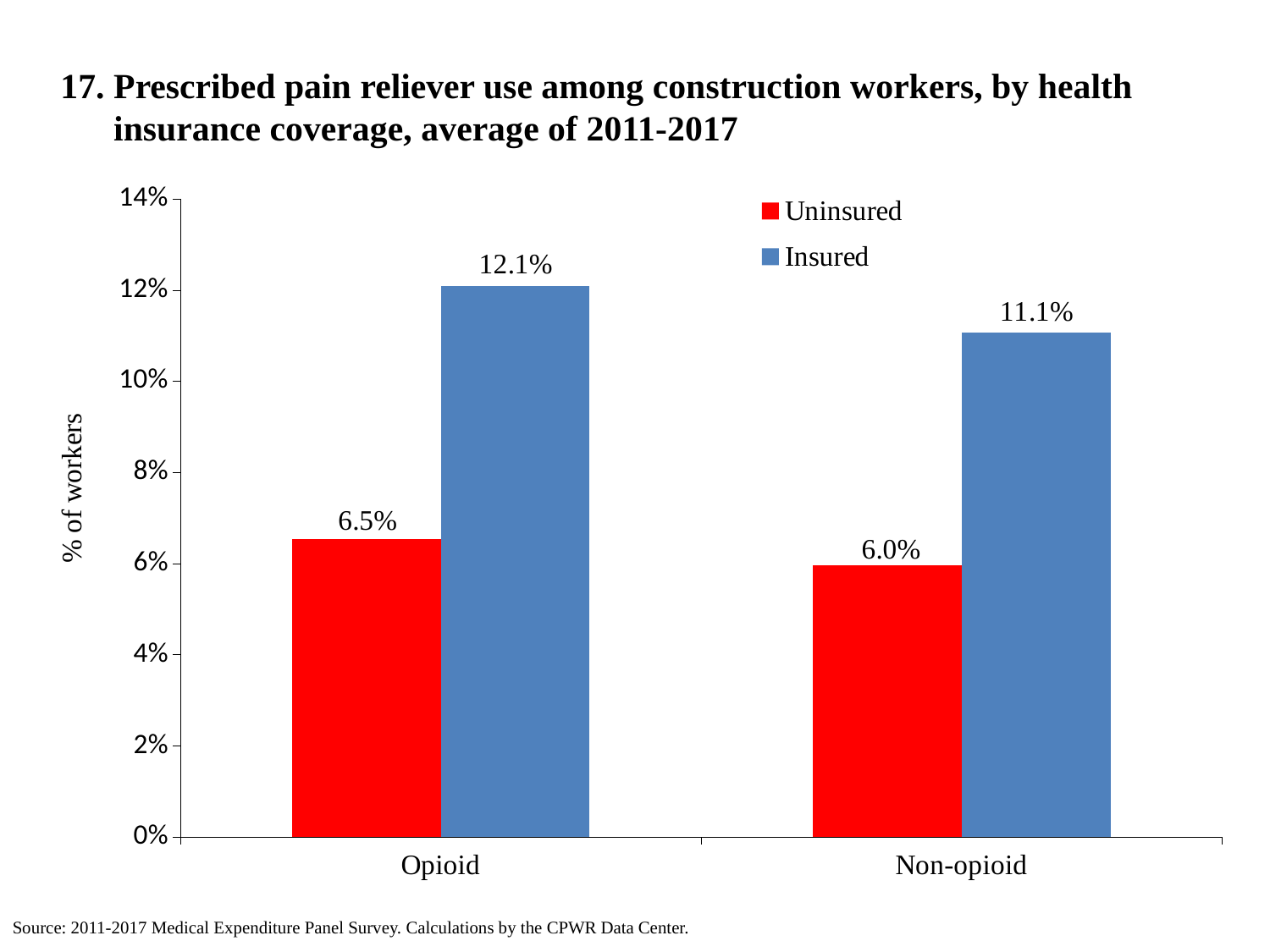
Which bar has the highest value on the chart? Insured, Opioid Which bar has the lowest value on the chart? Uninsured, Non-opioid Which is larger: the Insured value for Opioid or the Insured value for Non-opioid? Insured value for Opioid What is the value for Uninsured workers in the Opioid category? 6.5% Is the Insured value for Non-opioid greater or less than 10%? greater What is the value for Insured workers in the Non-opioid category? 11.1% How many series does the legend list? 2 What is the value for Insured workers in the Opioid category? 12.1% What kind of chart is shown on the slide? Bar chart What is the difference between the Insured and Uninsured values in the Opioid category? 5.6% What is the value for Uninsured workers in the Non-opioid category? 6.0% How many categories are shown on the x axis? 2